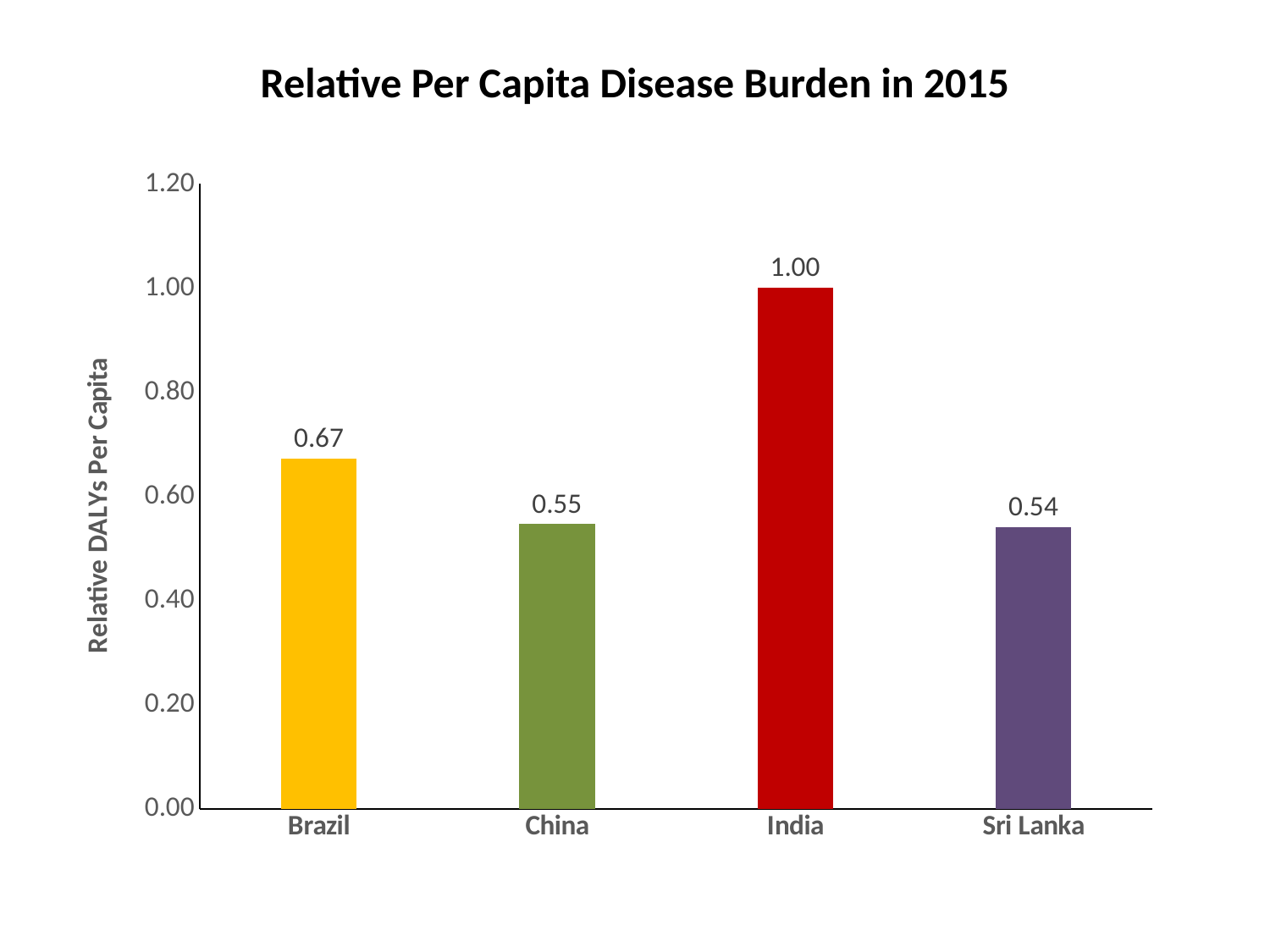
Which country has the lowest relative per capita disease burden? Sri Lanka What is the difference between the values for Brazil and China? 0.12 What is the title of the chart? Relative Per Capita Disease Burden in 2015 Which has a larger value, Brazil or China? Brazil What is the relative DALYs per capita value for China? 0.55 What kind of chart is shown on the slide? Bar chart Is the value for Brazil greater or less than 0.60? greater What is the relative DALYs per capita value for Brazil? 0.67 What is the difference between the values for India and Brazil? 0.33 Which country has the highest relative per capita disease burden? India What is the relative DALYs per capita value for Sri Lanka? 0.54 How many countries are shown in the chart? 4